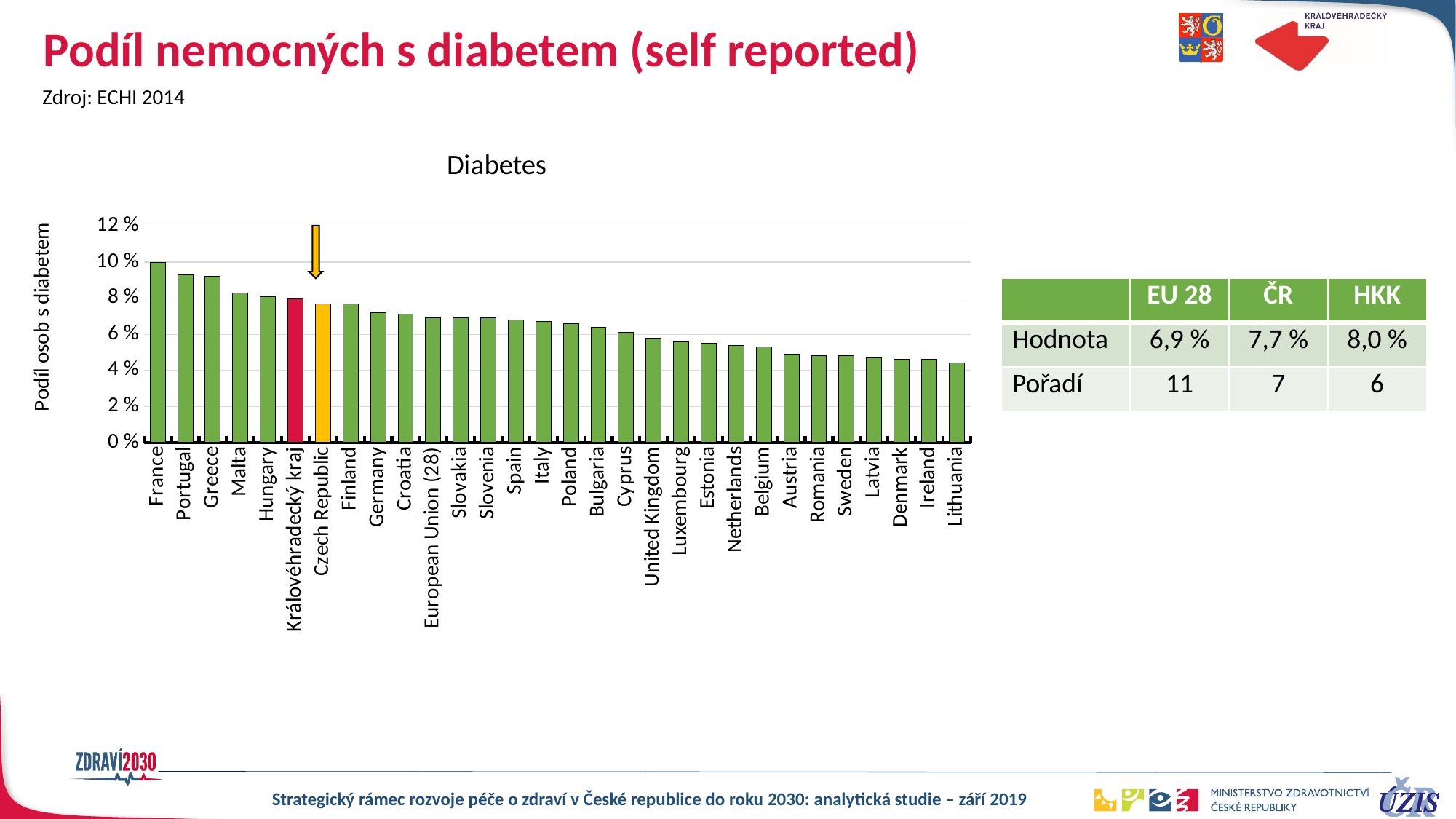
Is the value for France greater or less than 8 %? greater Is the value for Lithuania greater or less than 6 %? less How many countries/regions are plotted in the chart? 30 Which has a larger value, Portugal or Poland? Portugal According to the table, what is the difference between the HKK value and the EU 28 value? 1,1 % Which category has the lowest value in the chart? Lithuania What kind of chart is shown on the slide? bar chart Do the values rise or fall from left to right along the x axis? fall What is the title of the chart? Diabetes Which category has the highest value in the chart? France Is the value for Germany greater or less than 8 %? less According to the table next to the chart, what is the value (Hodnota) for ČR? 7,7 %